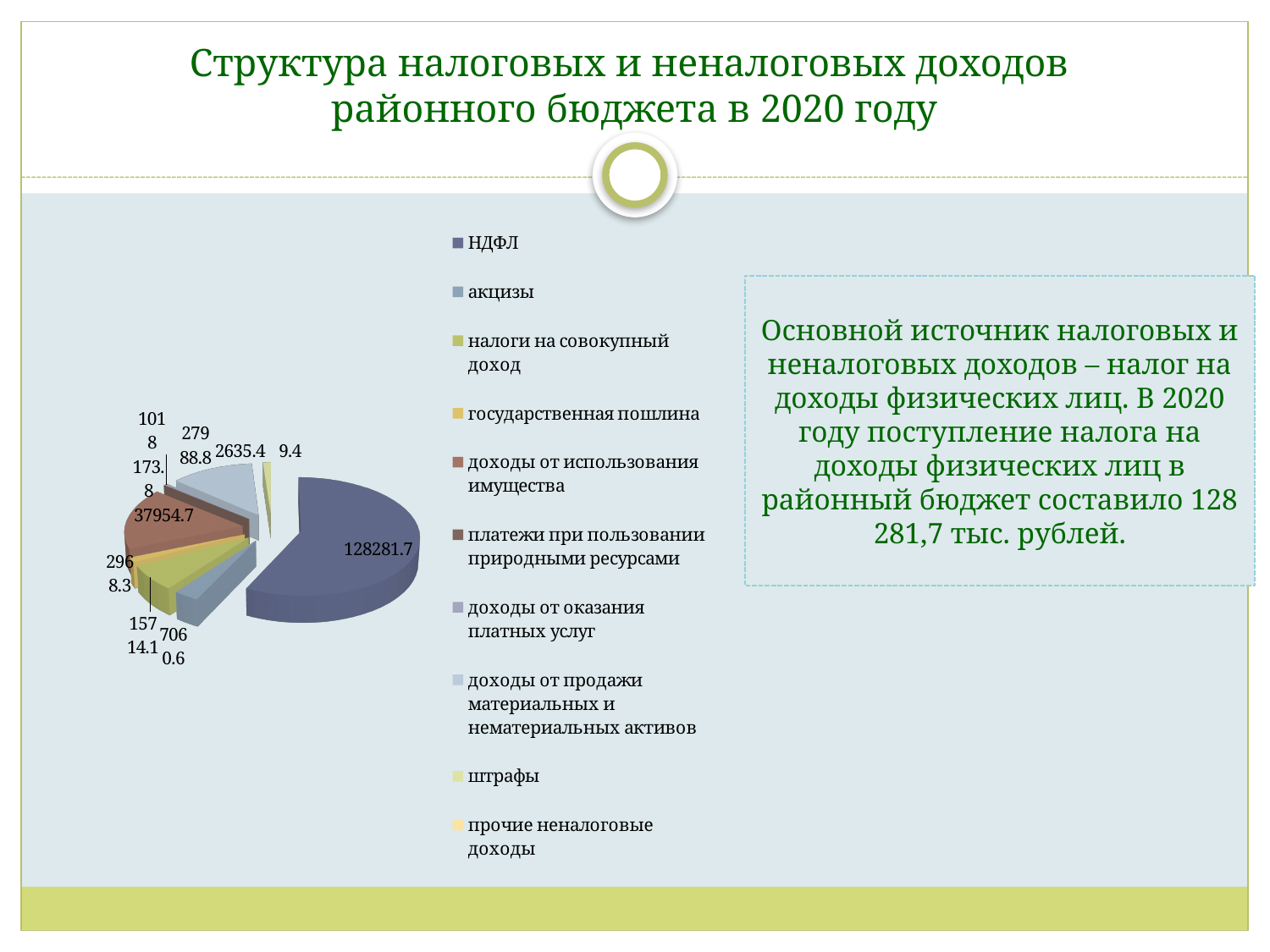
What kind of chart is shown on the slide? pie chart What is the value shown for штрафы in the pie chart? 2635.4 Which is larger: НДФЛ or доходы от использования имущества? НДФЛ What is the value shown for НДФЛ in the pie chart? 128281.7 What is the difference between the values for штрафы and прочие неналоговые доходы? 2626 What is the value shown for прочие неналоговые доходы in the pie chart? 9.4 What is the first entry in the chart's legend? НДФЛ What is the value shown for доходы от использования имущества in the pie chart? 37954.7 Which category has the smallest slice of the pie chart? прочие неналоговые доходы Which category has the largest slice of the pie chart? НДФЛ How many categories does the legend of the pie chart list? 10 What is the difference between the values for НДФЛ and доходы от использования имущества? 90327